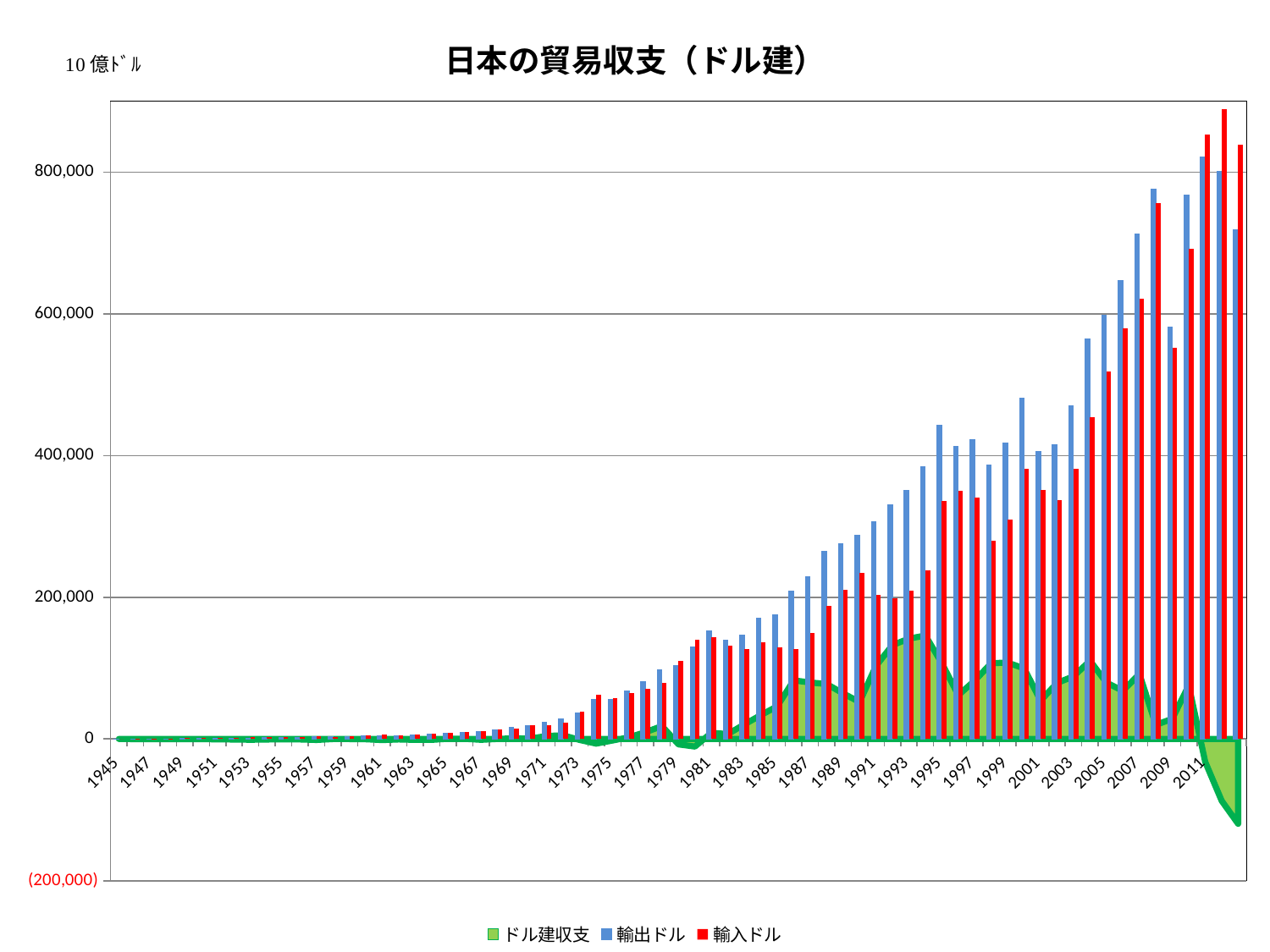
Is the value for 輸出ドル in 2007 greater or less than 600,000? greater Is the value for 輸入ドル in 1985 greater or less than 200,000? less Is the value for 輸出ドル in 1995 greater or less than 400,000? greater In 2011, which is larger, 輸出ドル or 輸入ドル? 輸入ドル Does the 輸出ドル series generally rise or fall from 1945 to 2011? rise How many series does the legend list? 3 What kind of chart is used for the 輸出ドル and 輸入ドル series? bar chart What is the title of the chart? 日本の貿易収支（ドル建） Which series is shown as a green area? ドル建収支 In 1995, which is larger, 輸出ドル or 輸入ドル? 輸出ドル